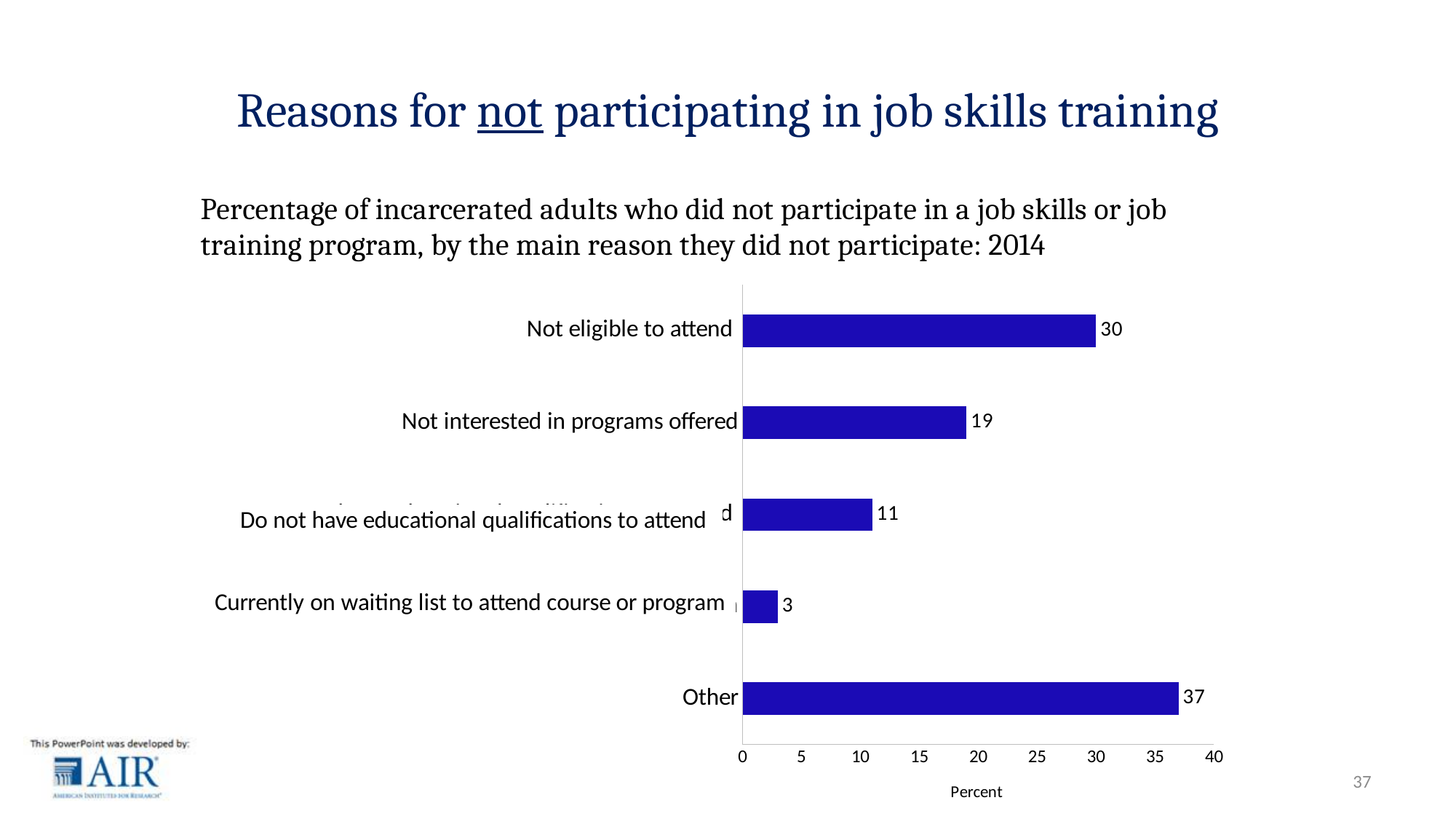
What is the value for 'Do not have educational qualifications to attend'? 11 Which reason has the highest percentage? Other What is the value for 'Not interested in programs offered'? 19 What is the difference between the values for 'Other' and 'Not eligible to attend'? 7 What is the label on the horizontal axis of the chart? Percent What percentage of incarcerated adults gave 'Not eligible to attend' as the main reason for not participating? 30 Which reason has the lowest percentage? Currently on waiting list to attend course or program How many reasons (categories) are shown in the chart? 5 Is the value for 'Not eligible to attend' greater or less than 25? greater What kind of chart is shown on the slide? Bar chart Which is larger: 'Not interested in programs offered' or 'Do not have educational qualifications to attend'? Not interested in programs offered What is the value for 'Currently on waiting list to attend course or program'? 3